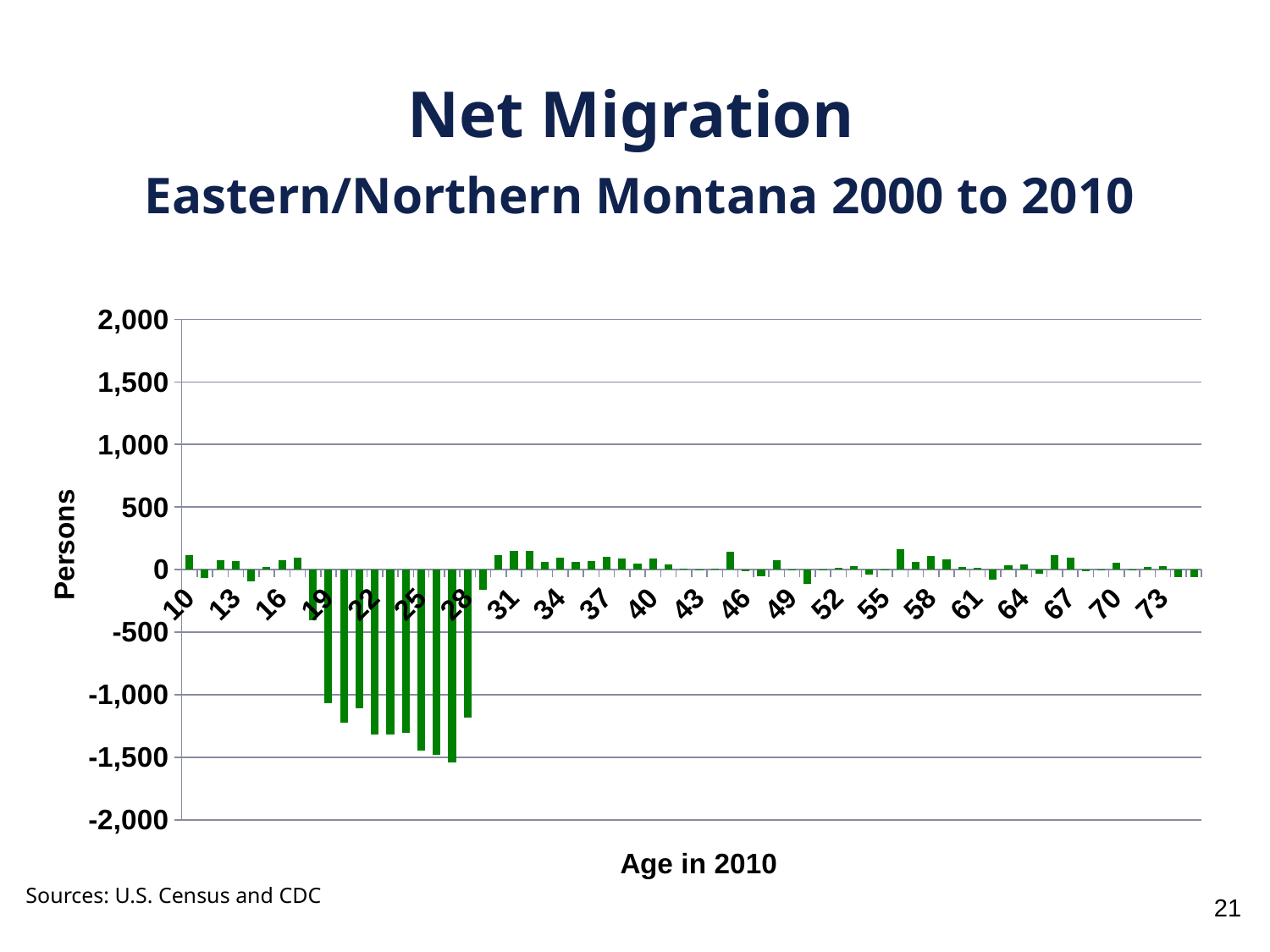
What is the label on the vertical axis of the chart? Persons Which has the lower net migration value, age 22 or age 28? Age 22 Is the net migration value for age 16 greater or less than 500? less Is the net migration value for age 28 greater or less than -1,000? less Is the net migration value for age 31 greater or less than 0? greater What kind of chart is shown on the slide? Bar chart Which has the larger net migration value, age 10 or age 19? Age 10 What is the label on the horizontal axis of the chart? Age in 2010 Which has the lower net migration value, age 19 or age 27? Age 27